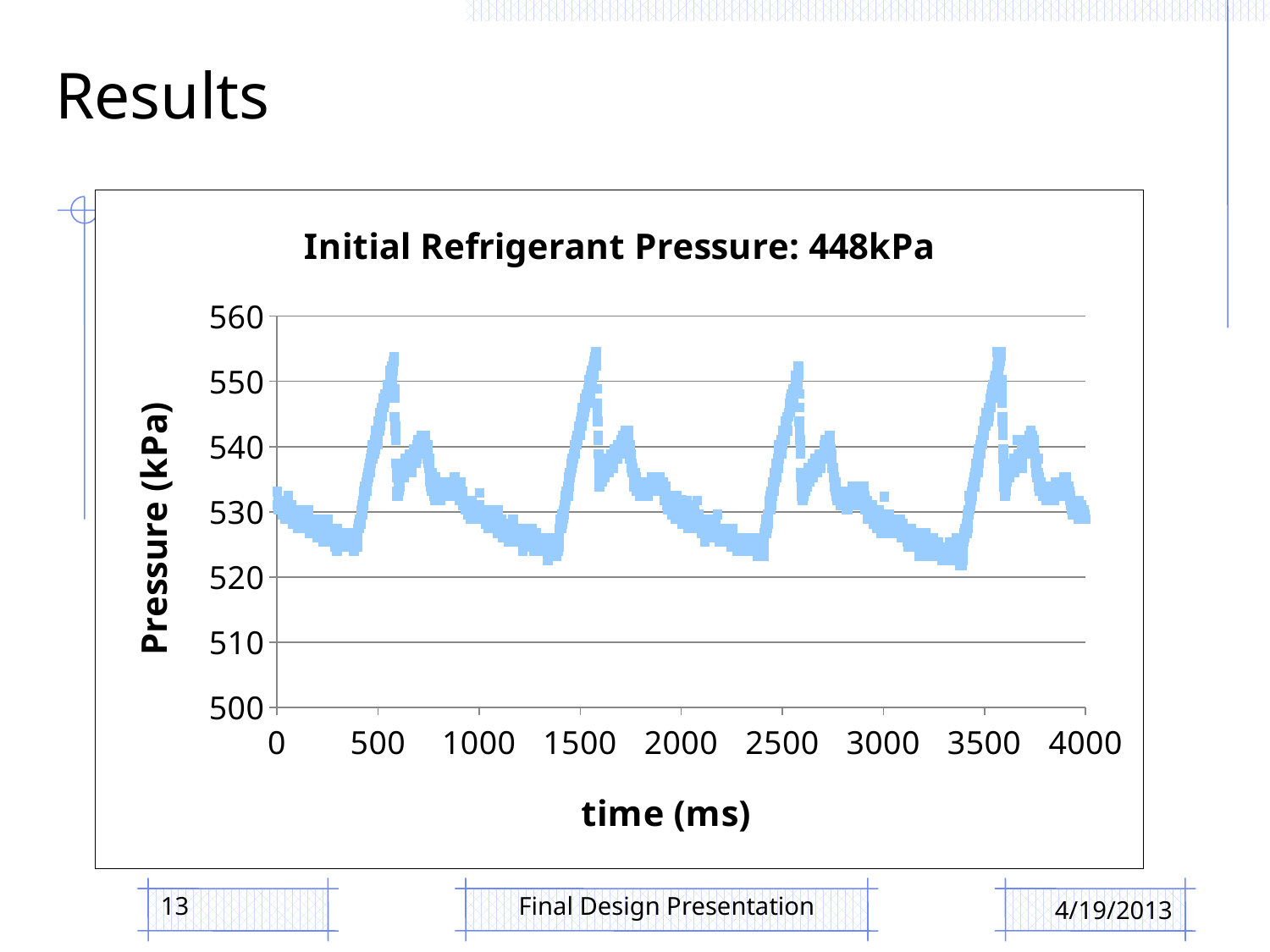
What is the title of the chart? Initial Refrigerant Pressure: 448kPa What type of chart is shown on the slide? scatter chart What is the label of the vertical axis? Pressure (kPa) What is the largest time value shown on the horizontal axis? 4000 How many sharp pressure spikes occur over the 4000 ms shown? 4 Is the peak pressure near 1600 ms greater or less than 550 kPa? greater Does the pressure follow a steady rise, a steady fall, or a repeating cyclic pattern over time? repeating cyclic pattern Is the lowest pressure near 3400 ms greater or less than 530 kPa? less Is the pressure at time 0 ms greater or less than 520 kPa? greater